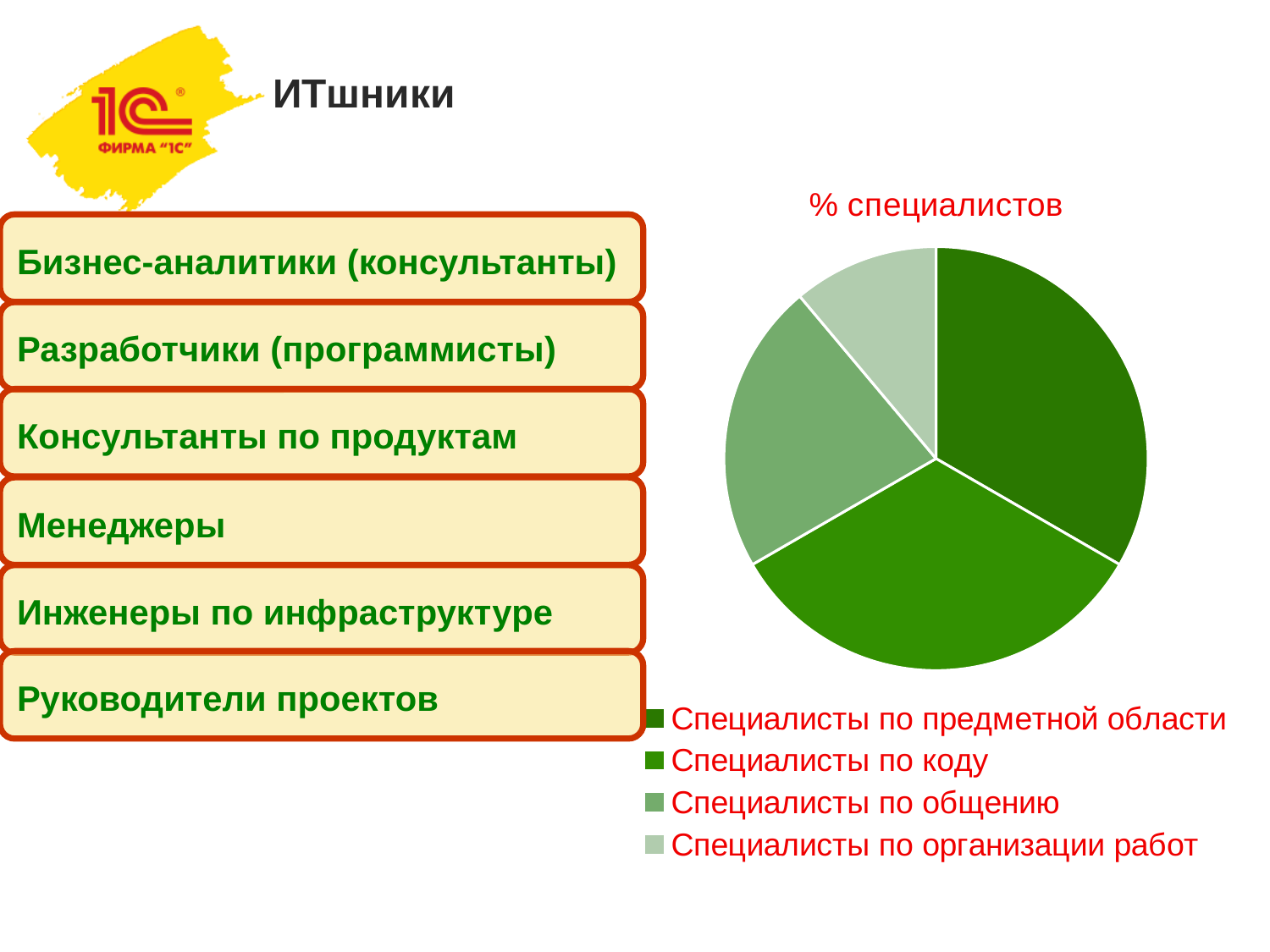
Which slice is larger: Специалисты по предметной области or Специалисты по организации работ? Специалисты по предметной области What kind of chart is shown on the slide? pie chart How many slices does the pie chart have? 4 Which slice is larger: Специалисты по общению or Специалисты по организации работ? Специалисты по общению Which legend entry is shown in the lightest green colour? Специалисты по организации работ Which slice is larger: Специалисты по коду or Специалисты по организации работ? Специалисты по коду How many entries does the legend of the pie chart list? 4 Which category has the smallest slice in the pie chart? Специалисты по организации работ What is the title of the pie chart? % специалистов